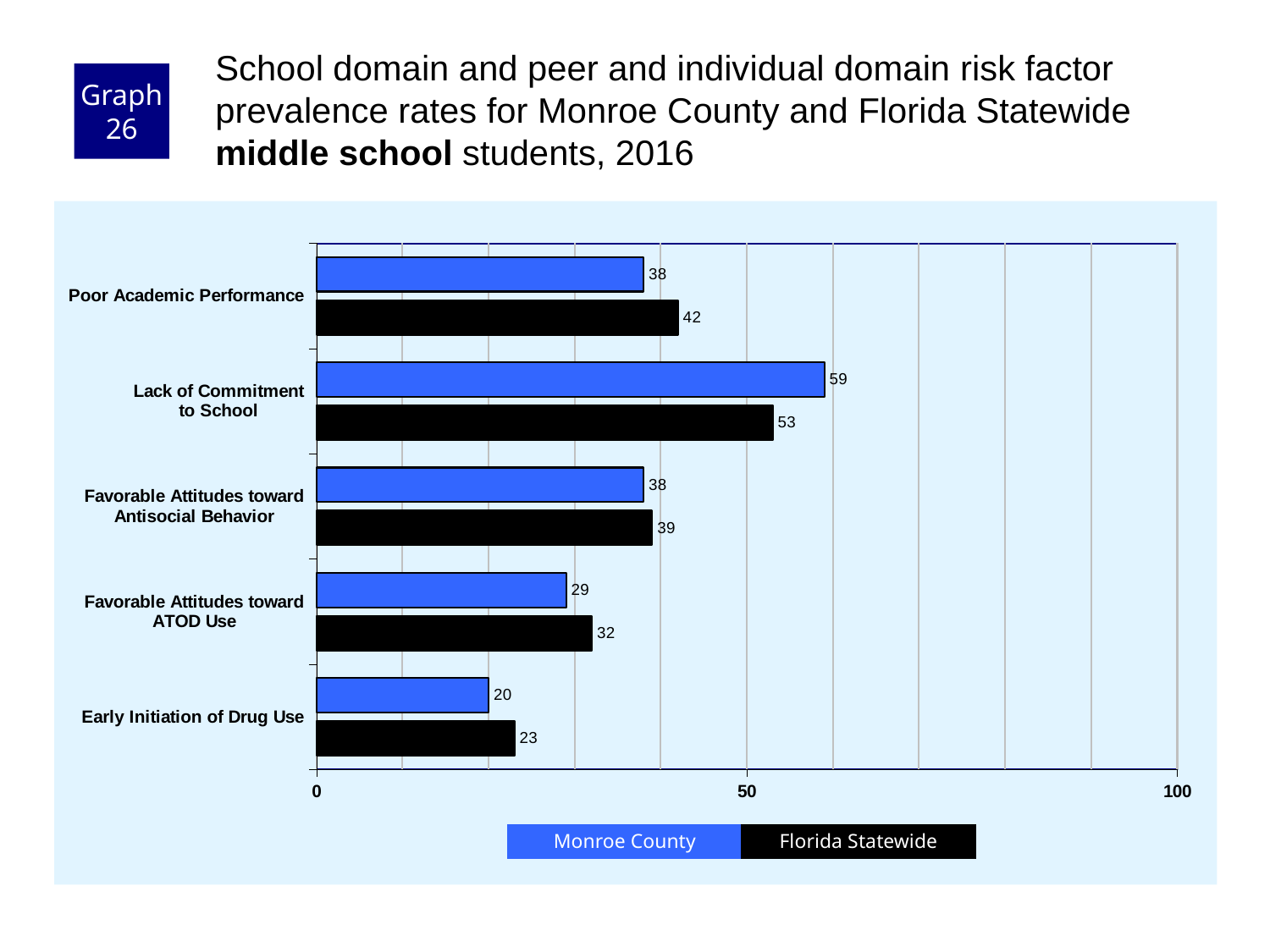
What is the Florida Statewide value for Favorable Attitudes toward ATOD Use? 32 Which risk factor has the lowest Florida Statewide value? Early Initiation of Drug Use How many series does the legend list? 2 Which colour represents Florida Statewide in the chart? black Is the Monroe County value for Lack of Commitment to School greater or less than 50? greater How many risk factor categories are shown on the chart? 5 What kind of chart is shown on the slide? bar chart Which risk factor has the highest Monroe County value? Lack of Commitment to School What is the Florida Statewide value for Early Initiation of Drug Use? 23 What is the difference between the Florida Statewide and Monroe County values for Poor Academic Performance? 4 For Lack of Commitment to School, which is larger: the Monroe County value or the Florida Statewide value? Monroe County What is the Monroe County value for Lack of Commitment to School? 59